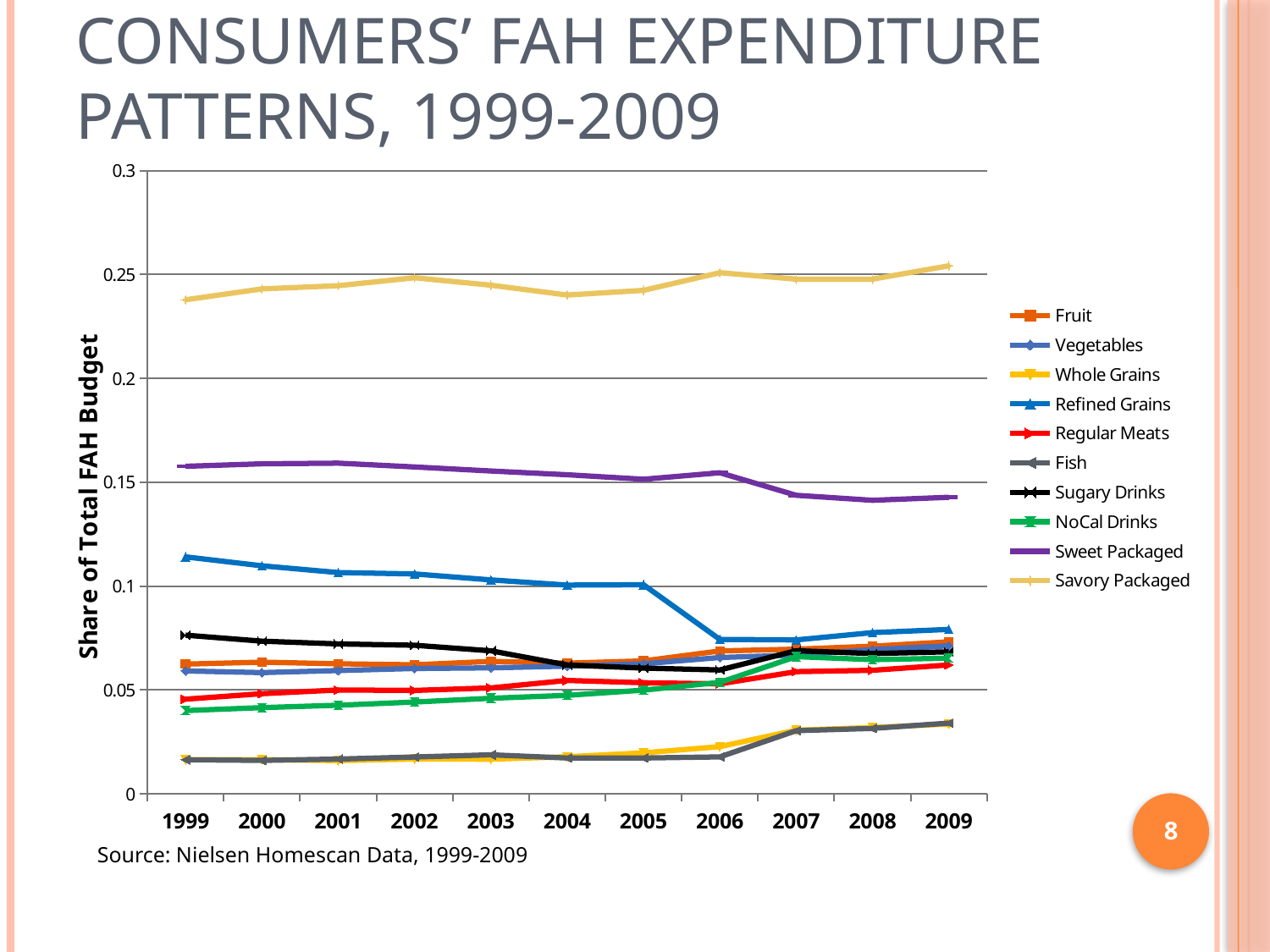
What kind of chart is shown on the slide? Line chart How many years are shown along the x axis? 11 Is the value for Savory Packaged in 1999 greater or less than 0.25? less Is the value for Sweet Packaged in 2009 greater or less than 0.15? less Which series has the highest share of the total FAH budget across all years? Savory Packaged Does the Refined Grains series rise or fall from 1999 to 2009? Fall Is the value for Refined Grains in 1999 greater or less than 0.1? greater Does the Fish series rise or fall from 1999 to 2009? Rise In 2005, which is larger: Sweet Packaged or Refined Grains? Sweet Packaged How many series does the legend list? 10 What is the label of the y axis? Share of Total FAH Budget